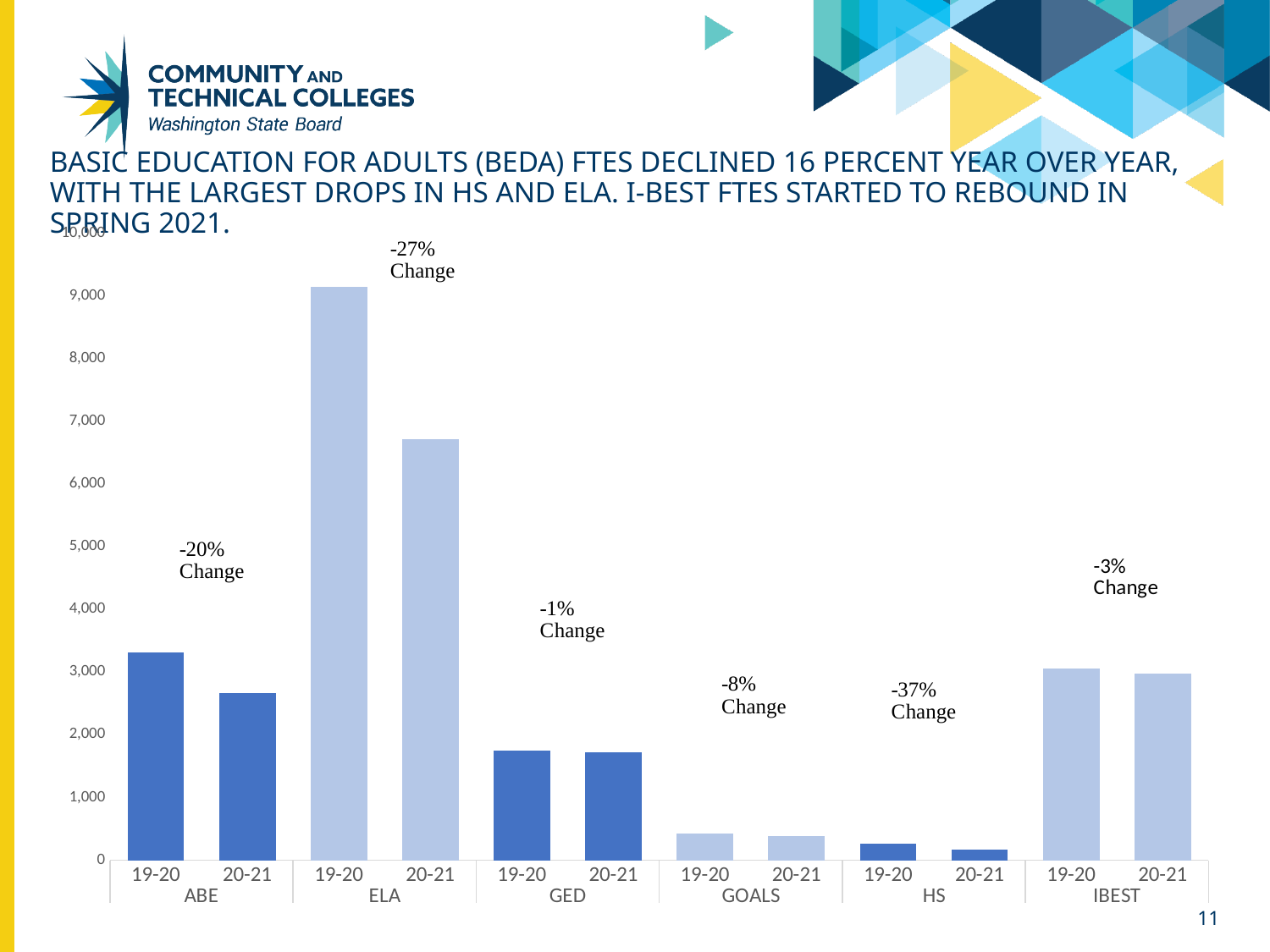
What percent change is annotated for ELA in the chart? -27% Change What percent change is annotated for GED in the chart? -1% Change Which is larger in the chart, ABE 19-20 or ABE 20-21? ABE 19-20 How many program categories are shown along the x axis of the chart? 6 Which bar in the chart is the tallest? ELA 19-20 What percent change is annotated for HS in the chart? -37% Change Which program category has the largest percent decline annotated in the chart? HS Is the value for GOALS 19-20 greater or less than 1,000? less Which program category has the smallest percent decline annotated in the chart? GED Is the value for ELA 20-21 greater or less than 7,000? less Is the value for ABE 19-20 greater or less than 3,000? greater What kind of chart is shown on the slide? bar chart